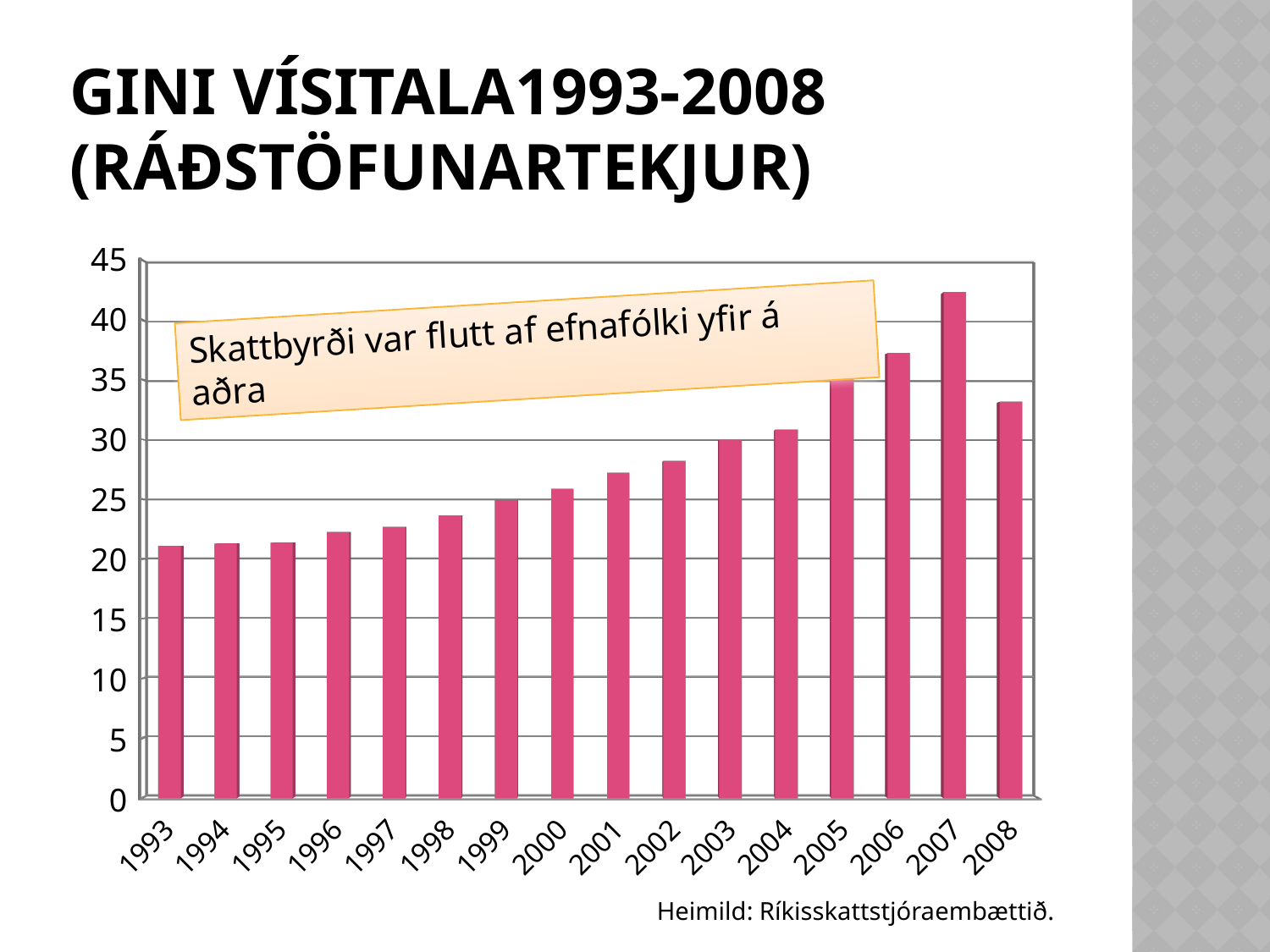
Is the value for 2001 greater or less than 30? less What source is cited below the chart? Ríkisskattstjóraembættið Is the value for 2006 greater or less than 35? greater Do the values generally rise or fall from 1993 to 2007? rise Which year has the highest Gini index value in the chart? 2007 Which is larger, the value for 2005 or the value for 2004? 2005 How many years are shown on the x axis of the chart? 16 Is the value for 2007 greater or less than 40? greater What kind of chart is shown on the slide? bar chart Which is larger, the value for 2007 or the value for 2008? 2007